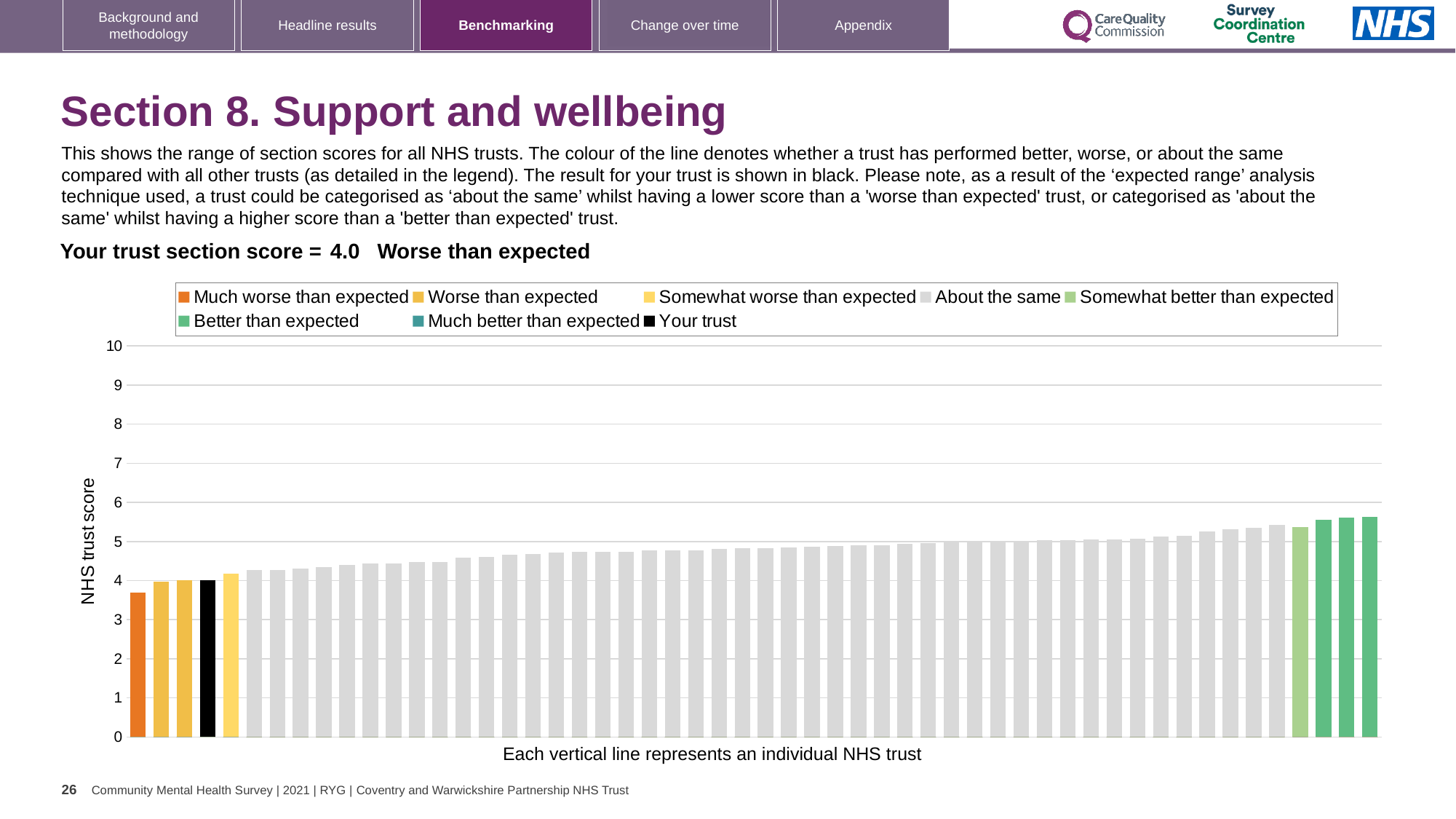
How is your trust's section score categorised on the slide? Worse than expected How many bars are coloured as 'Much worse than expected' (orange)? 1 How many entries does the chart legend list? 8 Is the value of the shortest bar (the orange bar) greater or less than 4? less Do the bar values rise or fall from left to right along the x axis? rise Is the value of the tallest bar in the chart greater or less than 5? greater What kind of chart is shown on the slide? bar chart Which legend category does the lowest-scoring trust in the chart belong to? Much worse than expected How many bars are coloured as 'Better than expected' (dark green)? 3 Is the value for your trust (the black bar) greater or less than 5? less What is the section score for your trust, as stated on the slide? 4.0 What is the label on the vertical axis of the chart? NHS trust score